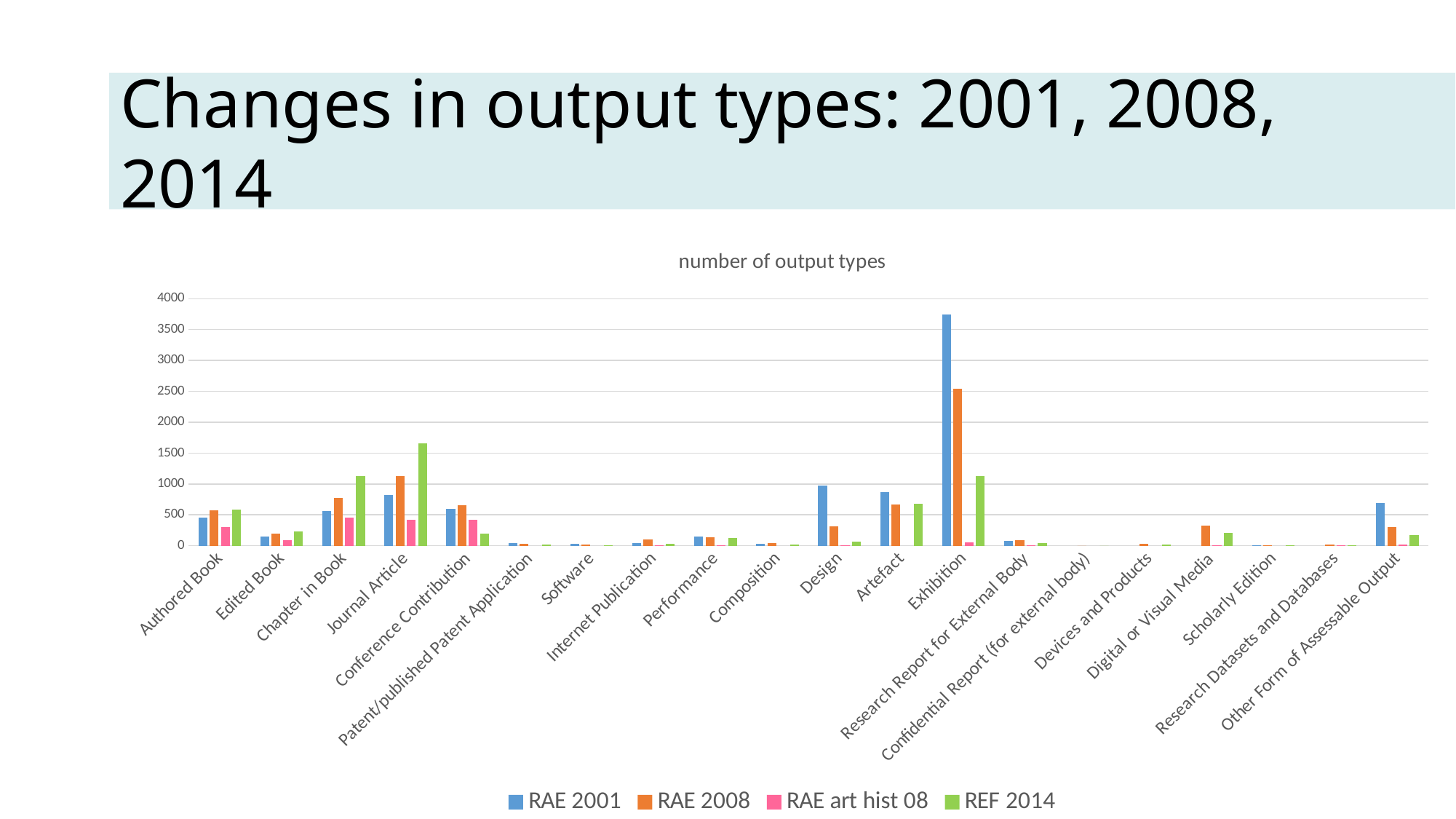
For Journal Article, which is larger: the RAE 2008 value or the REF 2014 value? REF 2014 Which category has the highest RAE 2001 value? Exhibition Which category has the highest REF 2014 value? Journal Article For Exhibition, which is larger: the RAE 2001 value or the RAE 2008 value? RAE 2001 What kind of chart is shown on the slide? bar chart How many output type categories are shown on the x axis? 20 What is the title of the chart? number of output types Is the RAE 2008 value for Exhibition greater or less than 2000? greater How many series does the legend list? 4 Is the REF 2014 value for Journal Article greater or less than 1500? greater Which series is shown in green in the legend? REF 2014 Is the RAE 2001 value for Exhibition greater or less than 3500? greater